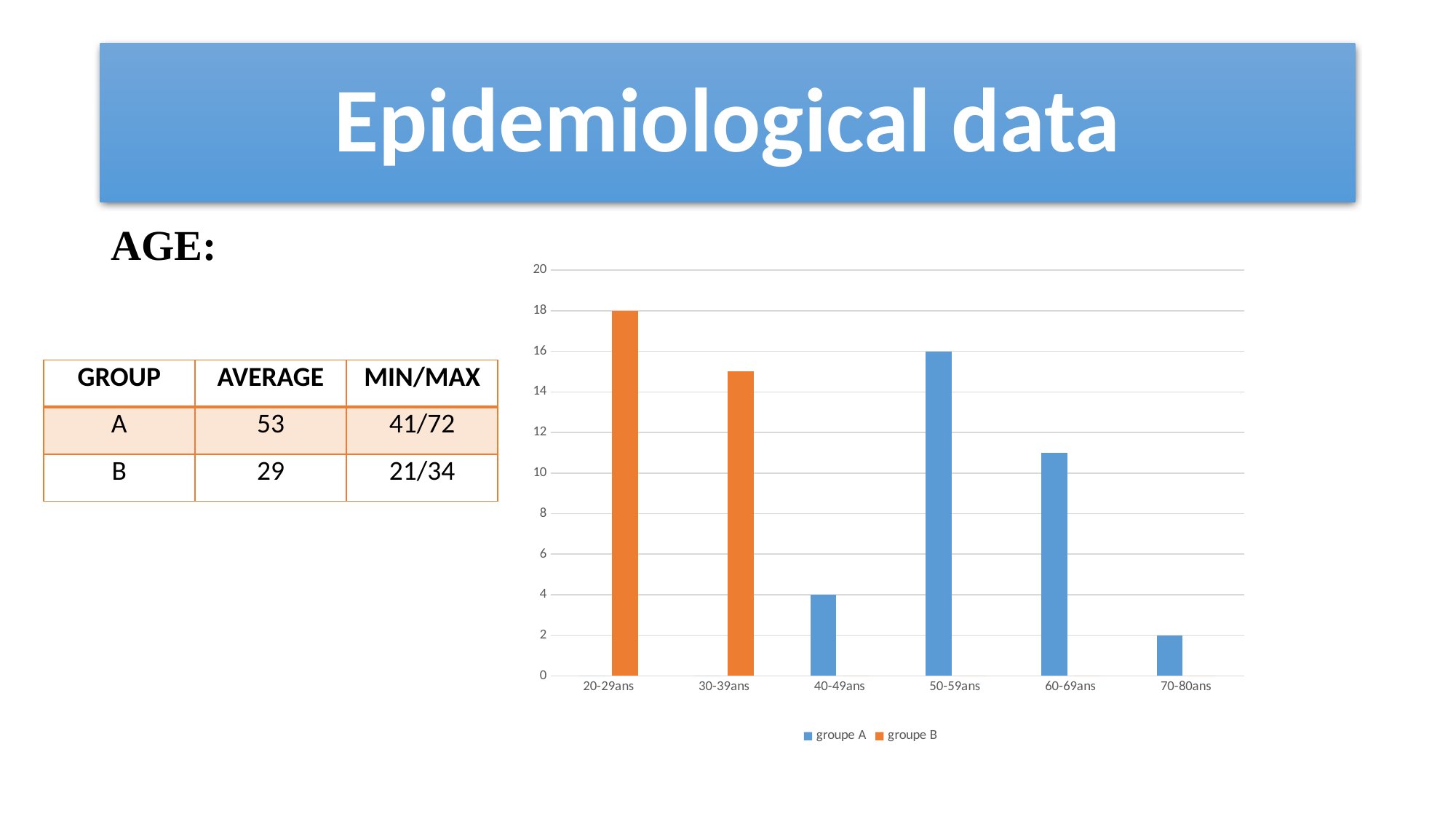
What is the value of the groupe A bar for 50-59ans? 16 Is the value for 30-39ans greater or less than 14? greater Which age category has the tallest bar in the chart? 20-29ans Is the value for 60-69ans greater or less than 12? less What is the value of the groupe A bar for 70-80ans? 2 What is the value of the groupe B bar for 20-29ans? 18 How many age categories are shown on the x axis of the chart? 6 What type of chart is shown on the slide? bar chart How many series does the chart legend list? 2 Which age category has the shortest bar in the chart? 70-80ans What is the value of the groupe A bar for 40-49ans? 4 What is the difference between the 50-59ans bar and the 40-49ans bar? 12